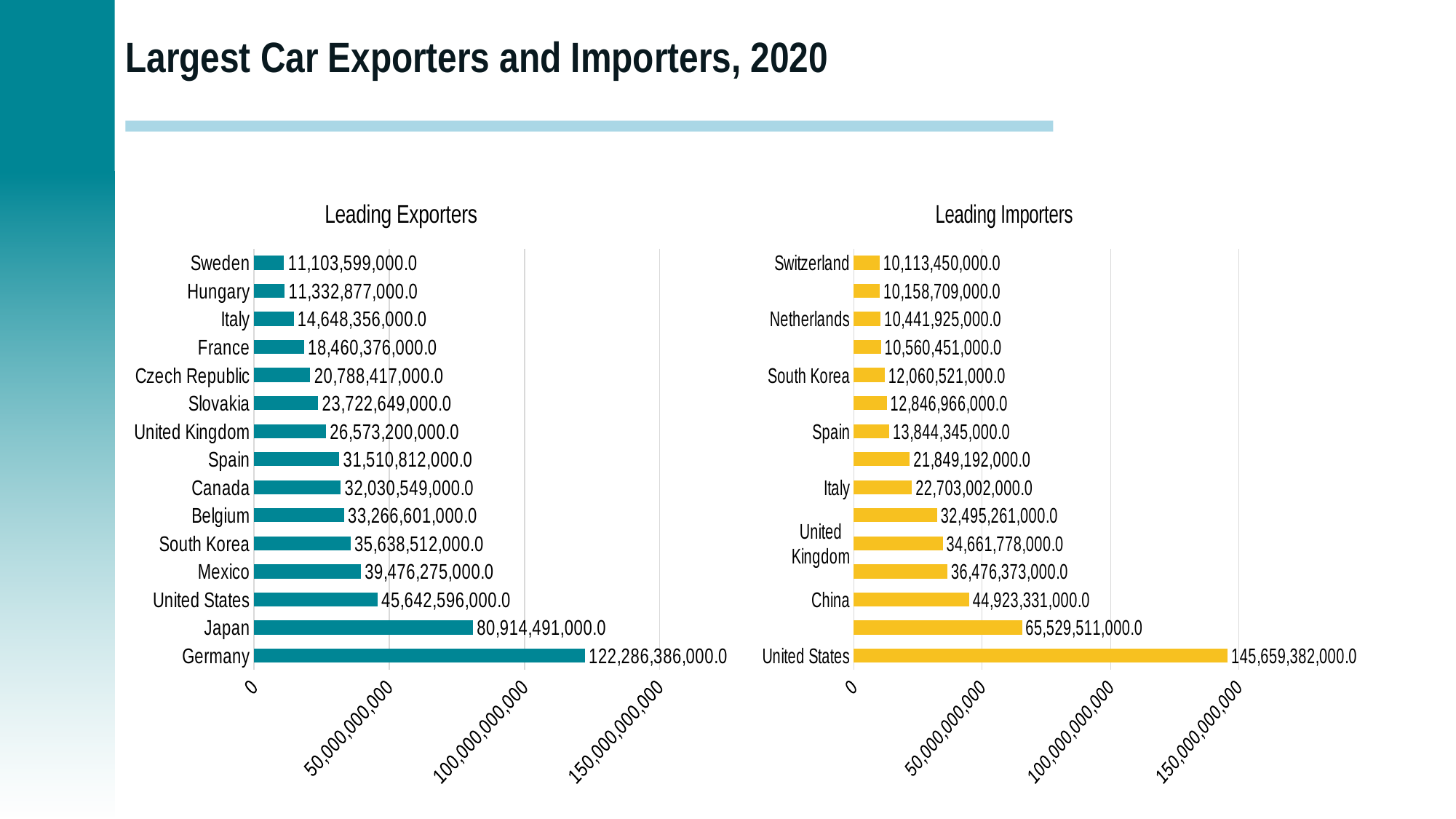
In the Leading Importers chart, is the value for United States greater or less than 100,000,000,000? greater How many countries are shown in the Leading Exporters chart? 15 In the Leading Exporters chart, which country has the lowest value? Sweden What colour are the bars in the Leading Importers chart? Yellow What kind of chart is the Leading Importers chart? Bar chart In the Leading Exporters chart, what is the value for Germany? 122,286,386,000.0 In the Leading Exporters chart, what is the value for Mexico? 39,476,275,000.0 In the Leading Exporters chart, what is the difference between Germany and Japan? 41,371,895,000.0 In the Leading Exporters chart, which is larger, the value for Canada or the value for Belgium? Belgium In the Leading Importers chart, what is the value for China? 44,923,331,000.0 In the Leading Importers chart, what is the value for Spain? 13,844,345,000.0 In the Leading Importers chart, which country has the highest value? United States